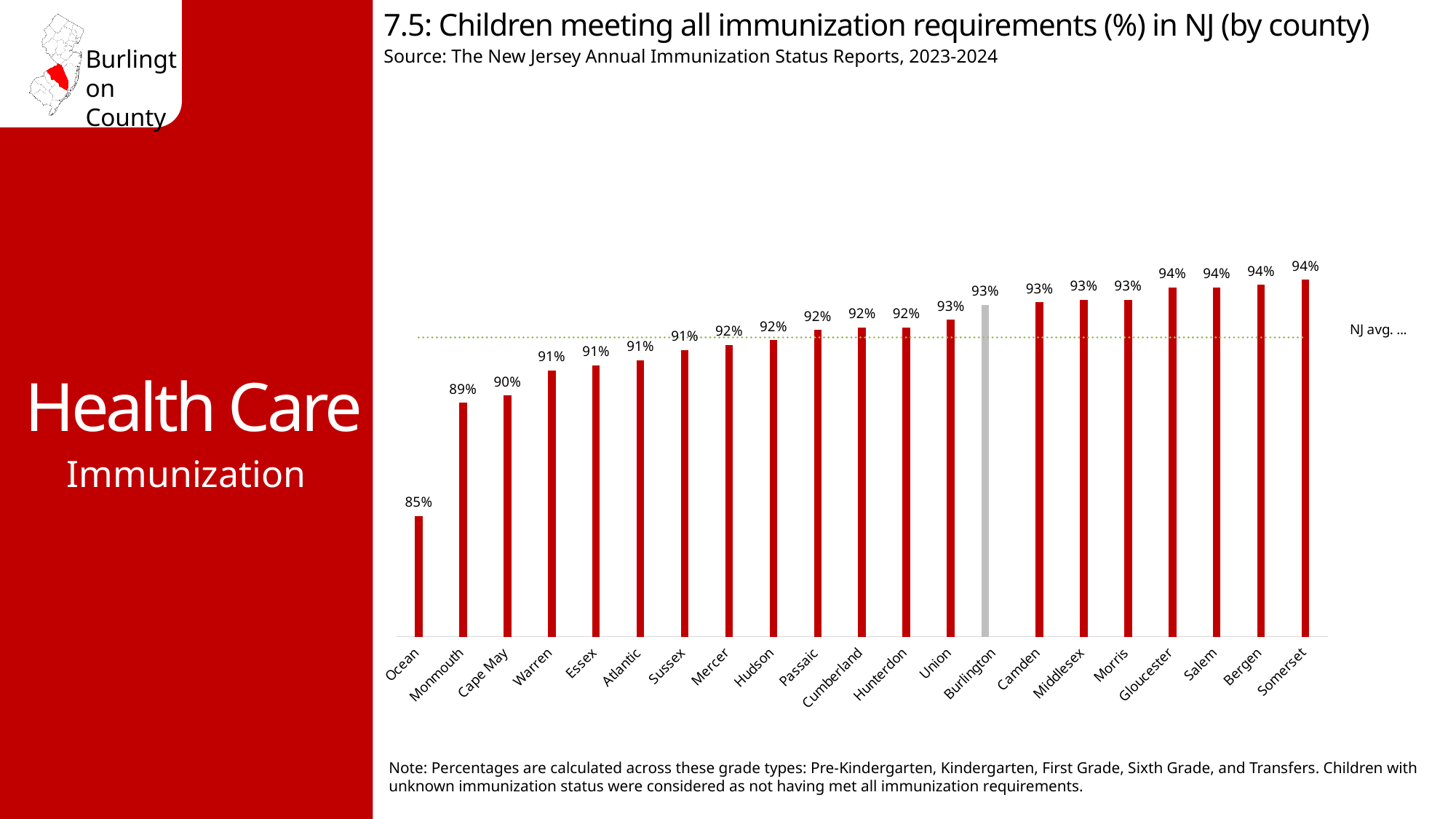
What is the value shown for Cape May? 90% What is the value shown for Somerset? 94% Which county has the lowest percentage of children meeting all immunization requirements? Ocean Which county's bar is coloured grey instead of red? Burlington What is the value shown for Burlington County? 93% What kind of chart is shown on the slide? Bar chart Which has a higher value, Monmouth or Cape May? Cape May What percentage of children in Ocean County met all immunization requirements? 85% What is the difference in percentage points between Somerset and Ocean? 9 percentage points What is the difference in percentage points between Burlington and Ocean? 8 percentage points How many counties are shown on the chart? 21 Do the values rise or fall moving from left to right along the x axis? Rise